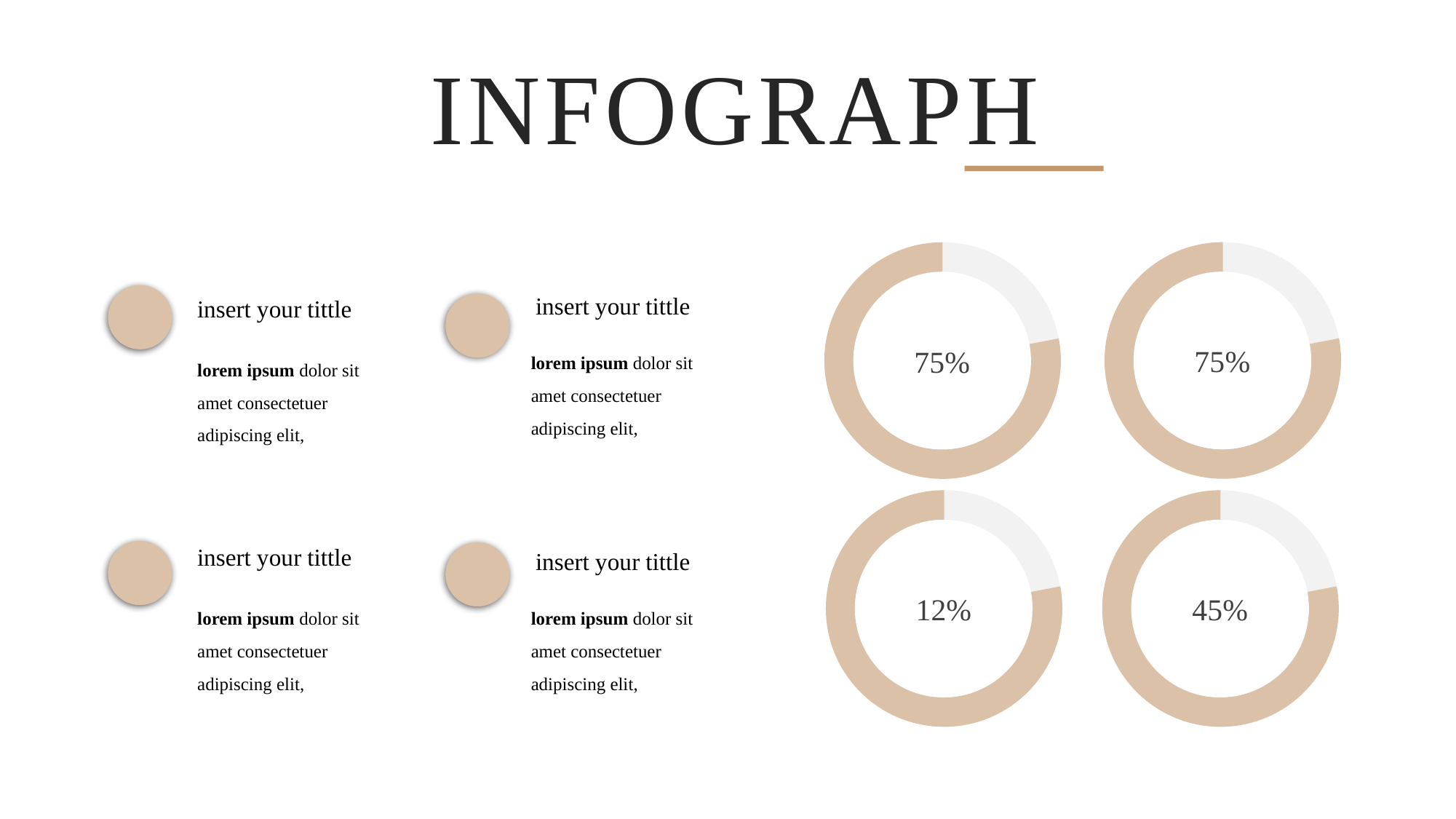
What is the title at the top of the slide? INFOGRAPH What percentage is shown in the centre of the top-left donut chart? 75% How many donut charts display the value 75%? 2 What kind of chart is used on the right side of the slide? Donut chart How many donut charts are on the slide? 4 What percentage is shown in the centre of the top-right donut chart? 75% What is the difference between the printed percentage of the top-left donut and the bottom-left donut? 63% Which printed percentage is larger, the bottom-left donut or the bottom-right donut? Bottom-right (45%) Which donut chart shows the lowest printed percentage? Bottom-left (12%) What percentage is shown in the centre of the bottom-right donut chart? 45% What is the difference between the printed percentage of the bottom-right donut and the bottom-left donut? 33% What percentage is shown in the centre of the bottom-left donut chart? 12%